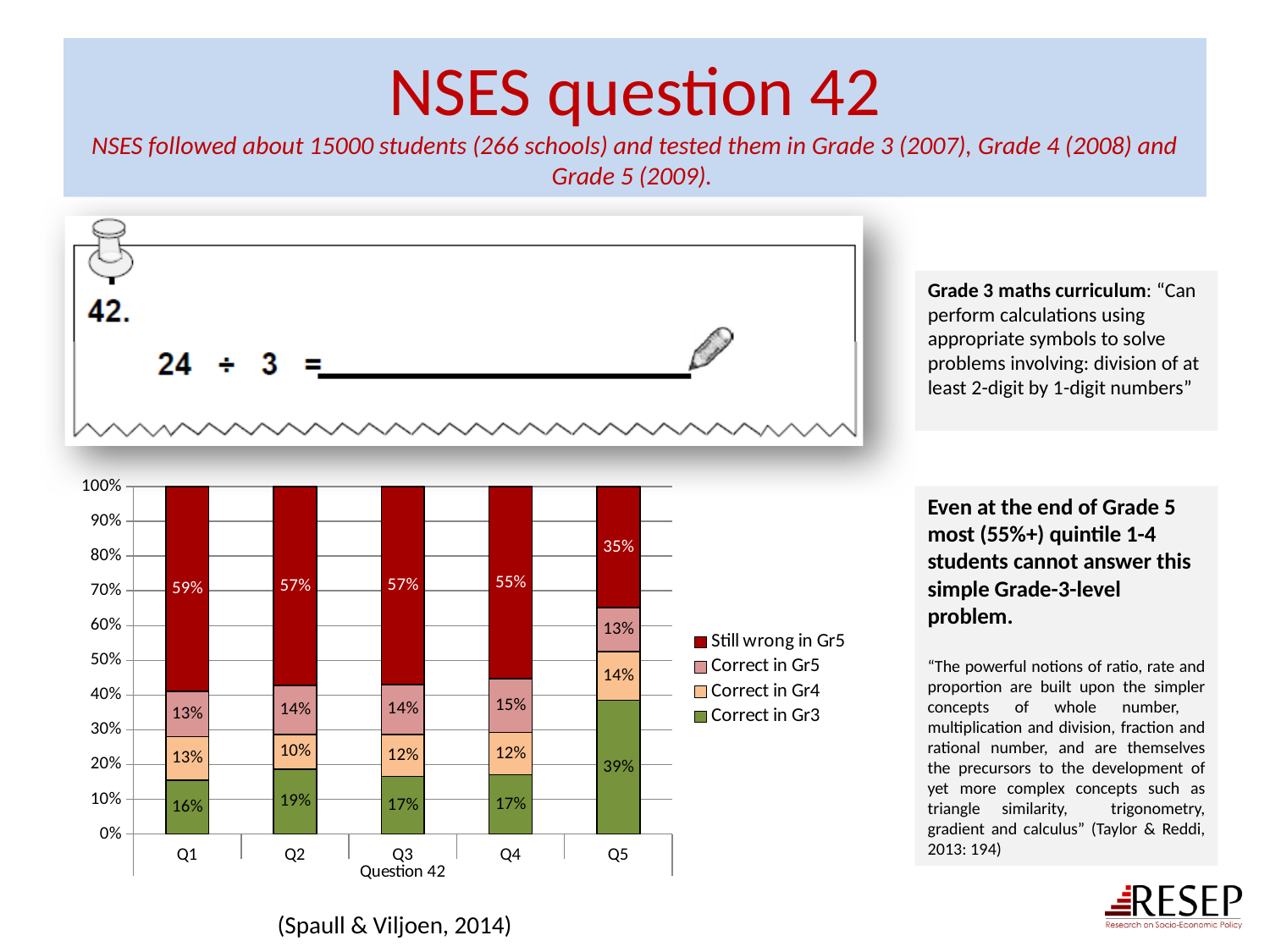
What is the 'Correct in Gr4' value for Q2? 10% What is the difference between the 'Still wrong in Gr5' values for Q1 and Q5? 24% What percentage of Q1 students answered Question 42 correctly in Gr3? 16% What percentage of Q5 students were still wrong in Gr5 on Question 42? 35% Which quintile has the lowest 'Correct in Gr3' percentage? Q1 What is the 'Correct in Gr5' value for Q4? 15% How many quintile categories are shown on the x axis? 5 What is the x-axis title of the chart? Question 42 How many series does the legend list? 4 Which quintile has the highest 'Still wrong in Gr5' percentage? Q1 Which is larger: the 'Correct in Gr3' value for Q5 or the 'Still wrong in Gr5' value for Q5? Correct in Gr3 (39%) What kind of chart is shown on the slide? Stacked bar chart